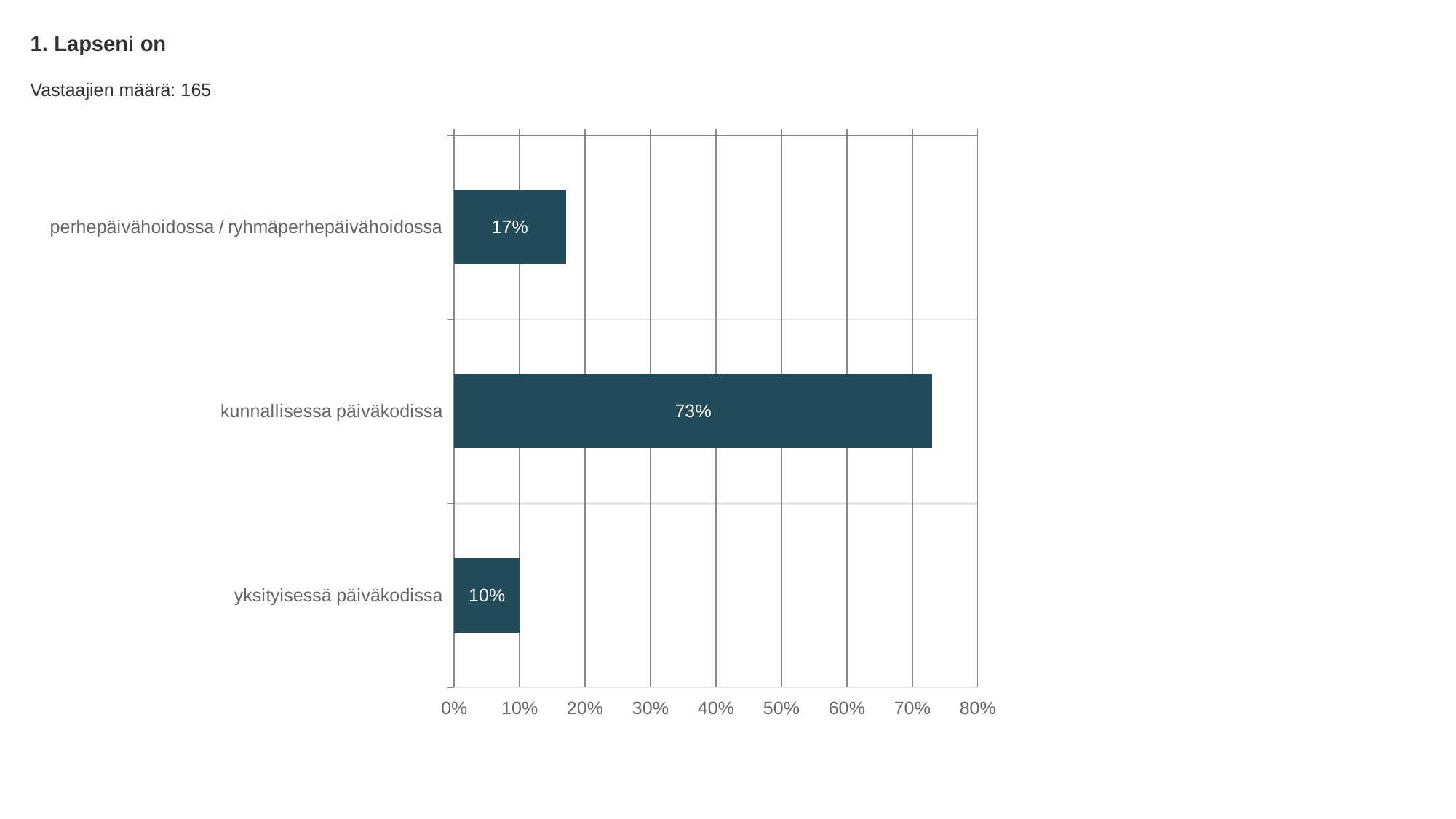
What is the difference in percentage points between 'kunnallisessa päiväkodissa' and 'perhepäivähoidossa / ryhmäperhepäivähoidossa'? 56 What kind of chart is shown on the slide? bar chart What percentage is shown for 'perhepäivähoidossa / ryhmäperhepäivähoidossa'? 17% Which category has the lowest percentage? yksityisessä päiväkodissa What percentage is shown for 'yksityisessä päiväkodissa'? 10% Which category has the highest percentage? kunnallisessa päiväkodissa What is the number of respondents (Vastaajien määrä) stated on the slide? 165 What is the difference in percentage points between 'perhepäivähoidossa / ryhmäperhepäivähoidossa' and 'yksityisessä päiväkodissa'? 7 Is the value for 'kunnallisessa päiväkodissa' greater or less than 70%? greater How many categories are shown in the chart? 3 Which is larger: the value for 'perhepäivähoidossa / ryhmäperhepäivähoidossa' or for 'yksityisessä päiväkodissa'? perhepäivähoidossa / ryhmäperhepäivähoidossa What percentage is shown for 'kunnallisessa päiväkodissa'? 73%